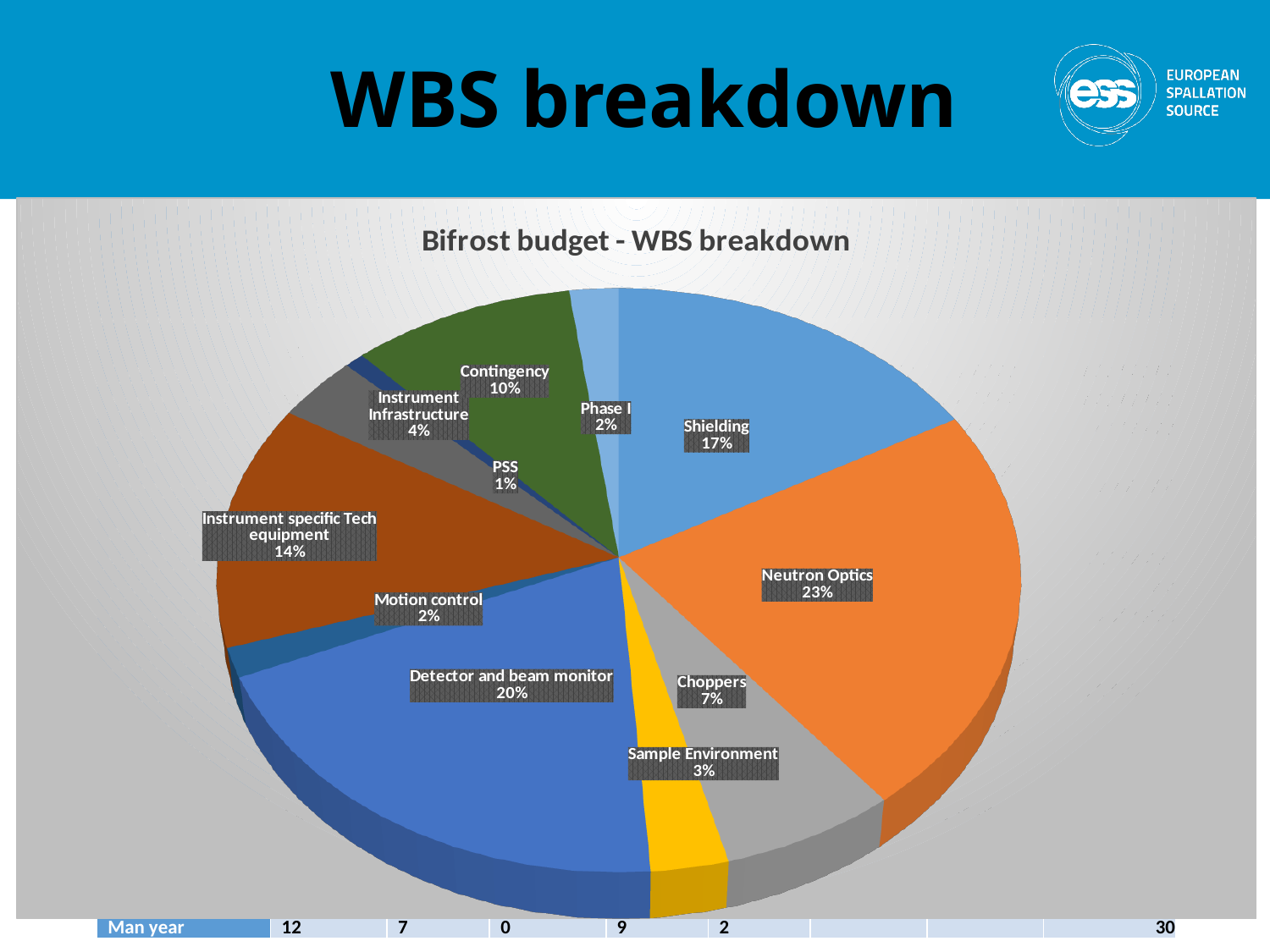
What is the difference in percentage points between the Neutron Optics share and the Shielding share? 6 What share of the Bifrost budget is Detector and beam monitor? 20% Which category has the smallest share of the Bifrost budget? PSS What is the title of the chart? Bifrost budget - WBS breakdown What share of the Bifrost budget is Contingency? 10% What share of the Bifrost budget is Neutron Optics? 23% How many slices does the pie chart have? 11 Which category has the largest share of the Bifrost budget? Neutron Optics What kind of chart is shown on the slide? pie chart Which has a larger share of the budget, Choppers or Sample Environment? Choppers